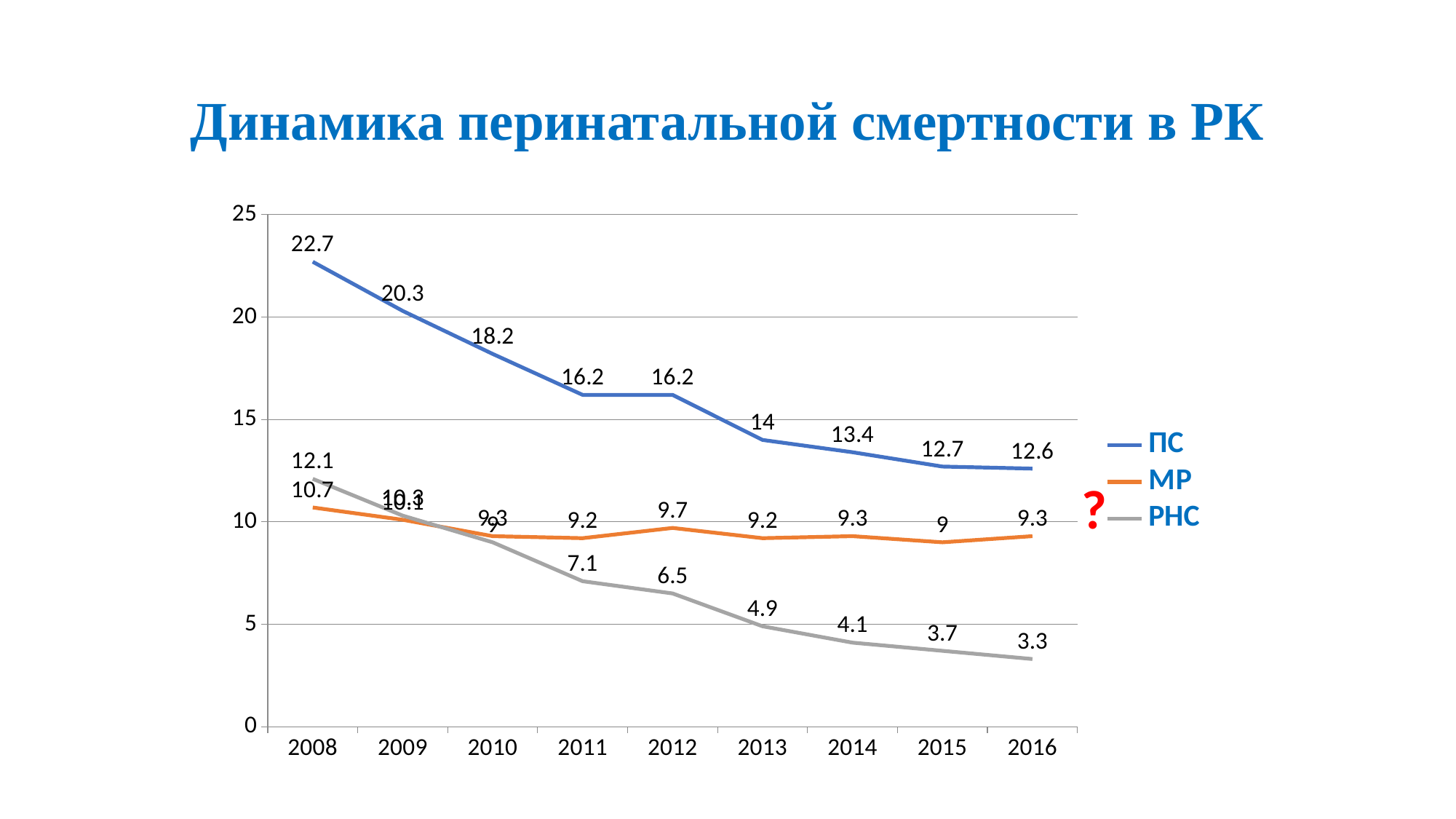
Does the РНС series rise or fall from 2008 to 2016? fall How many years are shown on the x axis? 9 What is the value of РНС in 2016? 3.3 What type of chart is shown on the slide? line chart In which year is the РНС series at its highest? 2008 What is the value of МР in 2012? 9.7 Which is larger in 2016, МР or РНС? МР What is the difference between the ПС values in 2008 and 2016? 10.1 What is the value of ПС in 2013? 14 In which year is the ПС series at its lowest? 2016 What is the value of ПС in 2008? 22.7 How many series does the legend list? 3